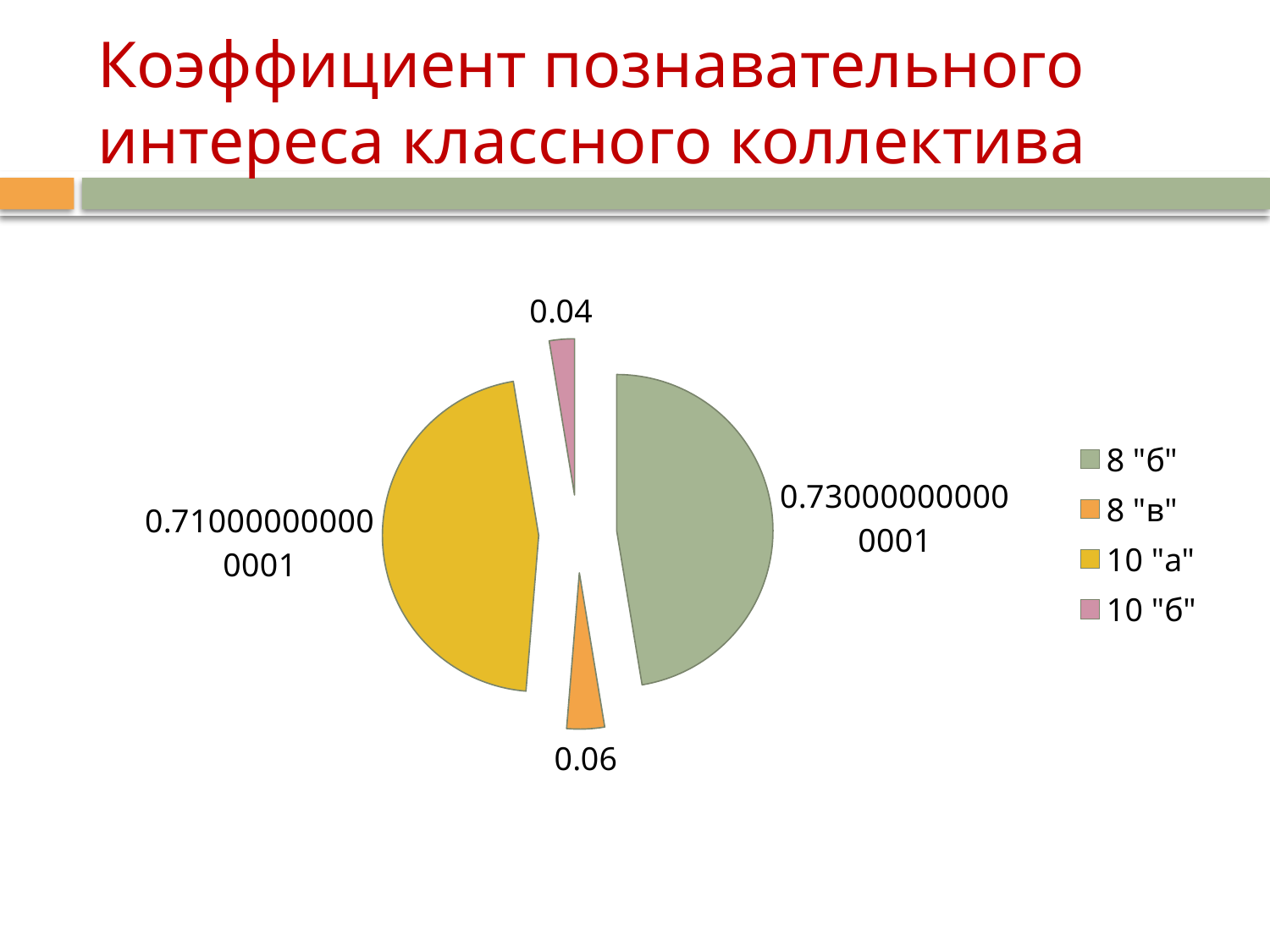
What is the value shown for 8 "б" in the pie chart? 0.730000000000001 Which is larger, the value for 8 "в" or the value for 10 "б"? 8 "в" What is the difference between the values for 8 "в" and 10 "б"? 0.02 What type of chart is shown on the slide? pie chart How many entries does the legend list? 4 How many slices does the pie chart have? 4 What is the title of the slide containing the pie chart? Коэффициент познавательного интереса классного коллектива Which class has the smallest slice in the pie chart? 10 "б" Which class has the largest slice in the pie chart? 8 "б" What is the value shown for 10 "б" in the pie chart? 0.04 What is the value shown for 10 "а" in the pie chart? 0.710000000000001 What is the value shown for 8 "в" in the pie chart? 0.06